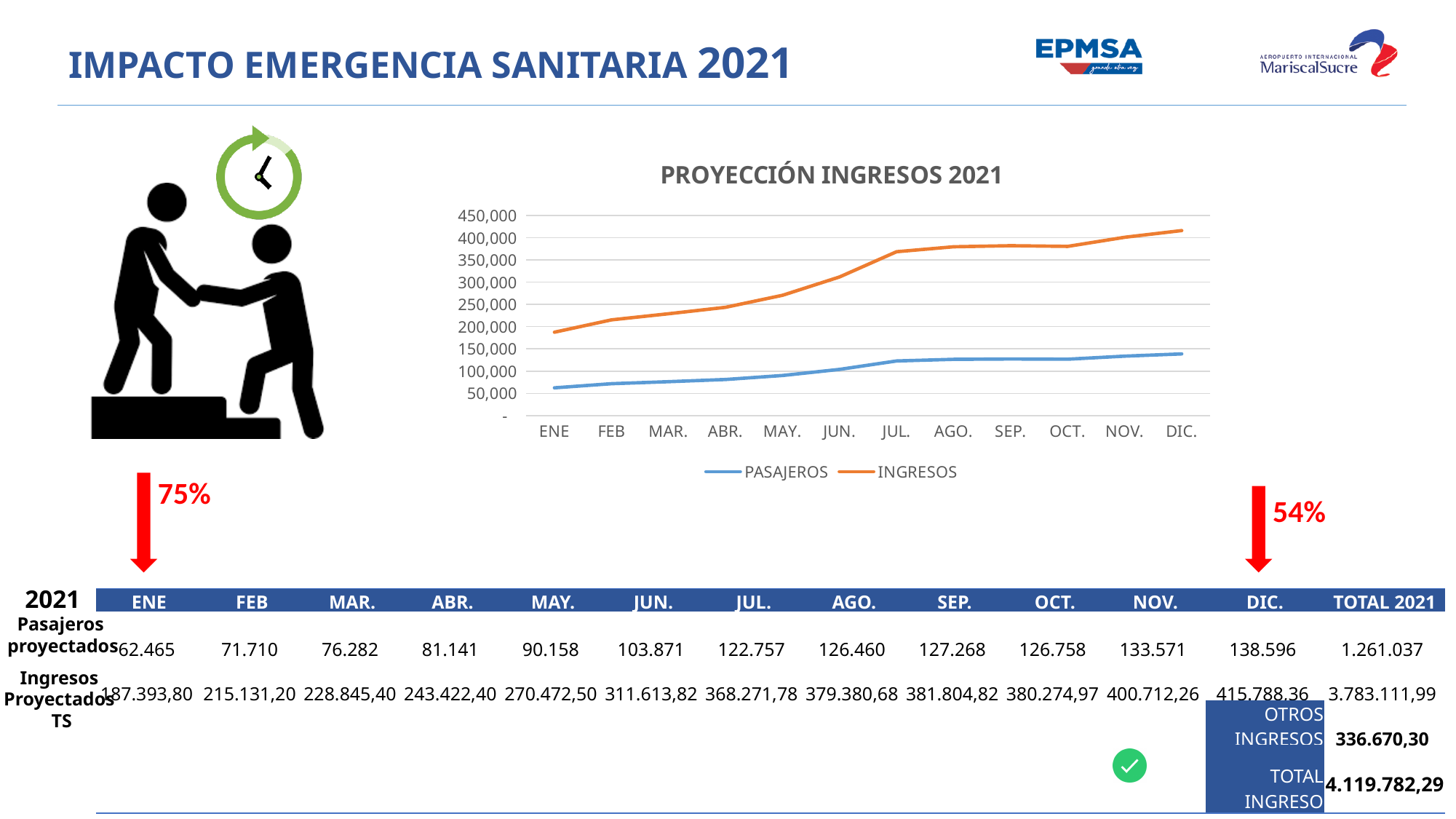
In the 'PROYECCIÓN INGRESOS 2021' chart, is the INGRESOS value for JUL. greater or less than 350,000? greater According to the table below the chart, what is the projected PASAJEROS value for DIC.? 138.596 In the 'PROYECCIÓN INGRESOS 2021' chart, is the PASAJEROS value for DIC. greater or less than 150,000? less How many series does the legend of the 'PROYECCIÓN INGRESOS 2021' chart list? 2 In the 'PROYECCIÓN INGRESOS 2021' chart, in which month is the PASAJEROS line lowest? ENE What kind of chart is 'PROYECCIÓN INGRESOS 2021'? line chart What are the two legend entries of the 'PROYECCIÓN INGRESOS 2021' chart? PASAJEROS and INGRESOS In the 'PROYECCIÓN INGRESOS 2021' chart, in which month is the INGRESOS line highest? DIC. In the 'PROYECCIÓN INGRESOS 2021' chart, does the INGRESOS line generally rise or fall from ENE to DIC? rise How many months are plotted along the x axis of the 'PROYECCIÓN INGRESOS 2021' chart? 12 In the 'PROYECCIÓN INGRESOS 2021' chart, which series is higher in JUL., PASAJEROS or INGRESOS? INGRESOS In the 'PROYECCIÓN INGRESOS 2021' chart, is the INGRESOS value for ENE greater or less than 200,000? less